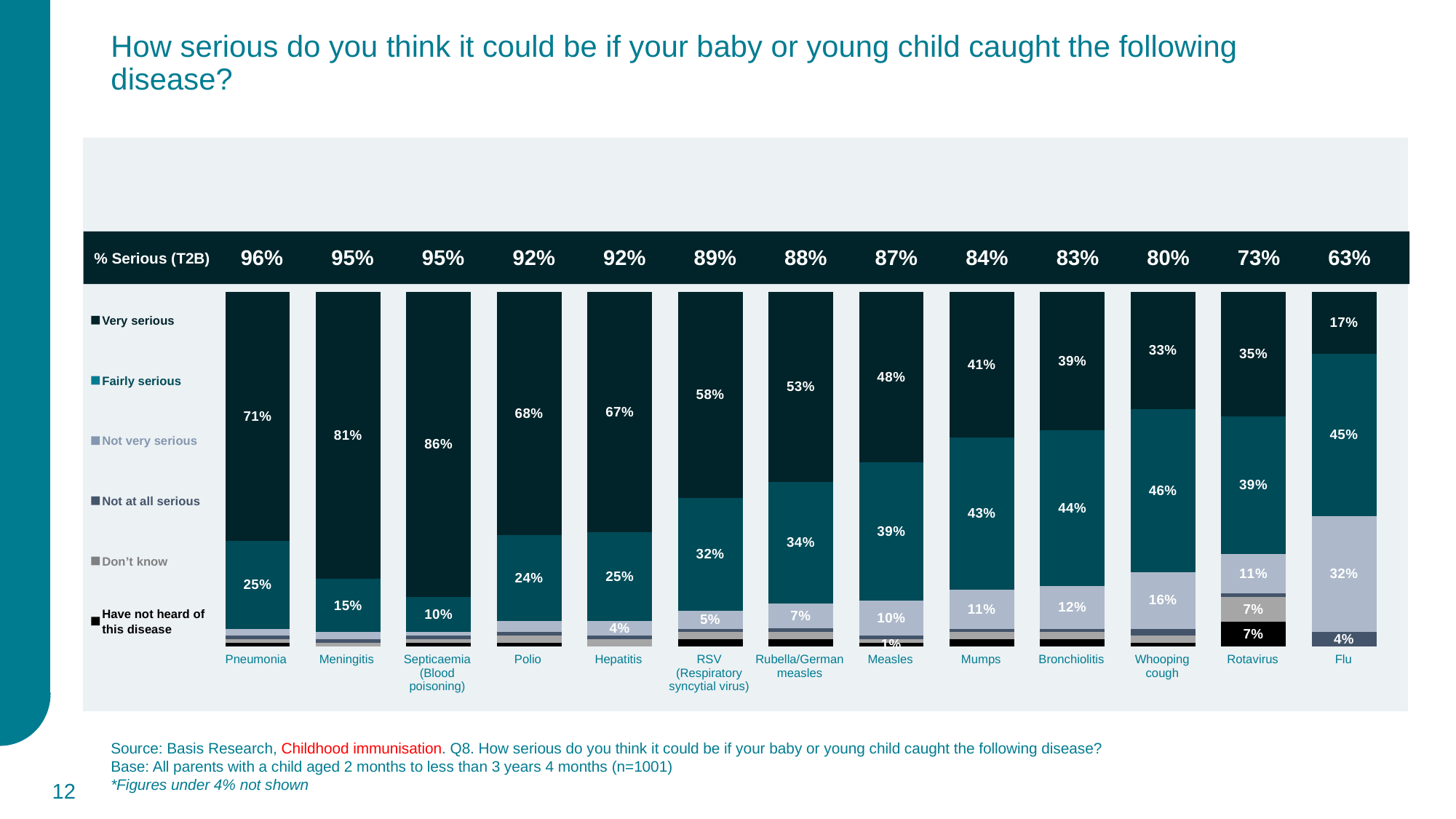
What is the % Serious (T2B) figure shown for Rotavirus? 73% How many diseases are shown along the x axis of the chart? 13 What is the 'Not very serious' value for Flu? 32% Which disease has the highest 'Very serious' percentage? Septicaemia (Blood poisoning) What is the 'Fairly serious' value for Whooping cough? 46% For Pneumonia, how many percentage points higher is 'Very serious' than 'Fairly serious'? 46 percentage points For Mumps, which is larger: the 'Very serious' share or the 'Fairly serious' share? Fairly serious What percentage of parents said it would be very serious if their child caught Septicaemia (Blood poisoning)? 86% How many response categories does the legend list? 6 Do the % Serious (T2B) figures rise or fall moving from left to right across the diseases? Fall What kind of chart is shown on the slide? Stacked bar chart Which disease has the lowest 'Very serious' percentage? Flu